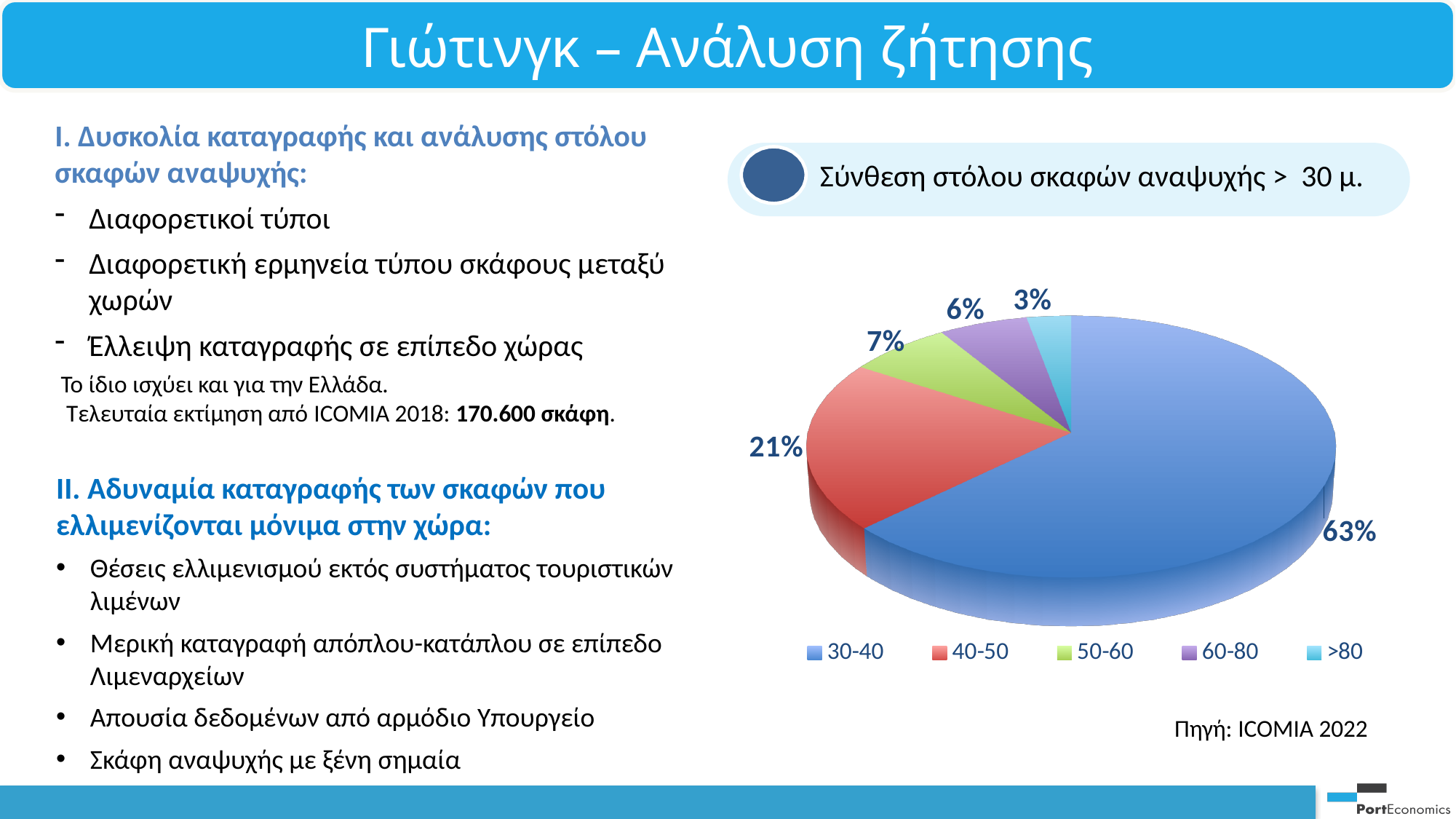
How many categories does the pie chart show? 5 What share of the pie does the 50-60 category hold? 7% What is the difference in percentage points between the 30-40 and 40-50 slices? 42 Which slice is larger, 50-60 or 60-80? 50-60 What is the source cited below the chart? ICOMIA 2022 What kind of chart is shown on the slide? Pie chart What share of the pie does the >80 category hold? 3% Which category has the smallest slice of the pie? >80 What share of the pie does the 40-50 category hold? 21% What share of the pie does the 60-80 category hold? 6% What share of the pie does the 30-40 category hold? 63% Which category has the largest slice of the pie? 30-40